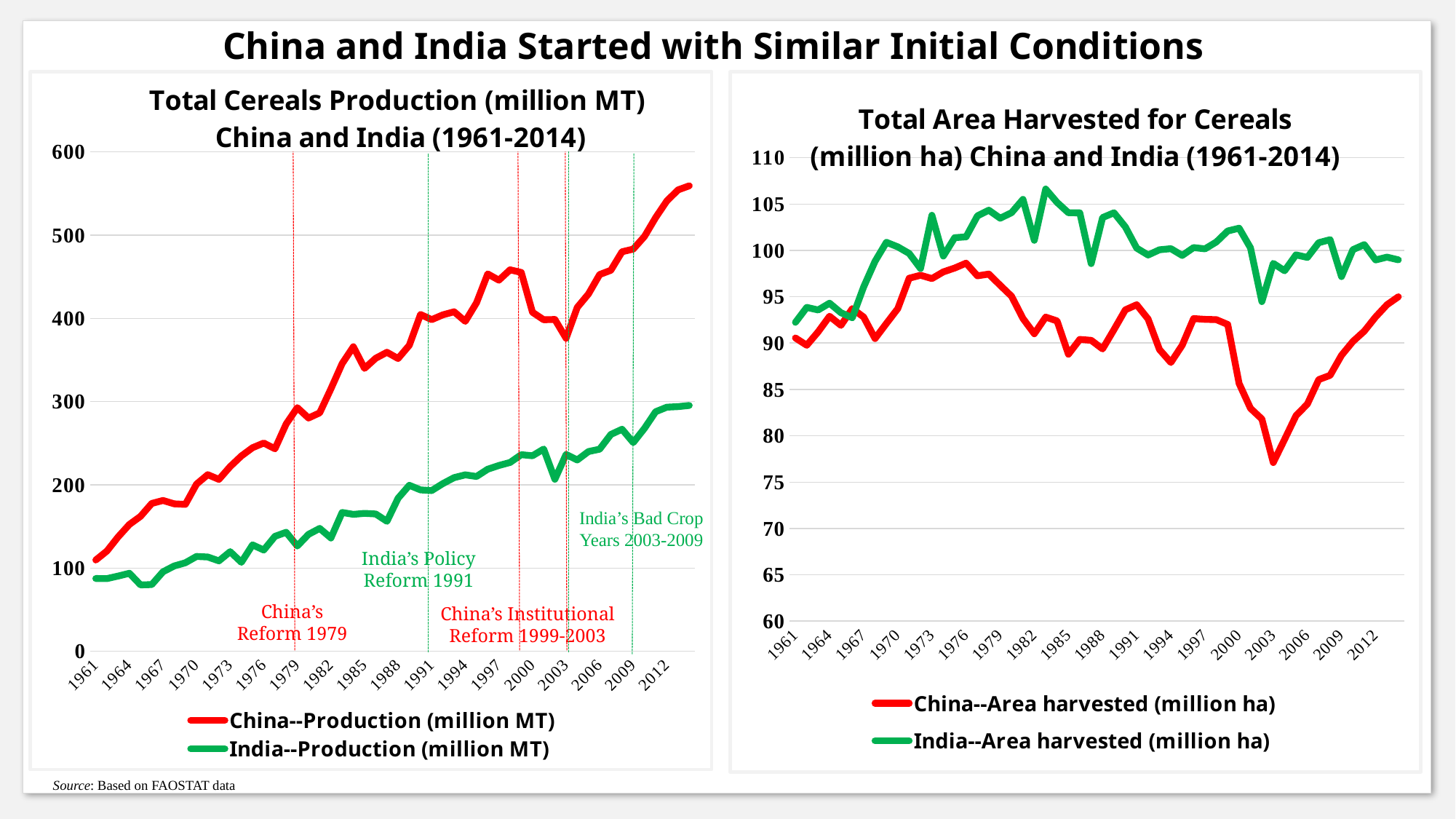
What kind of chart is the 'Total Cereals Production (million MT)' chart on the left? line chart In the 'Total Cereals Production' chart on the left, which country has the higher production in 2012, China or India? China How many series does the legend of the 'Total Area Harvested for Cereals' chart on the right list? 2 In the 'Total Area Harvested for Cereals' chart on the right, is the value for China in 2003 greater or less than 80? less In the 'Total Cereals Production' chart on the left, what year is labelled as China's Reform? 1979 In the 'Total Cereals Production' chart on the left, does India's production generally rise or fall from 1961 to 2014? rise In the 'Total Cereals Production' chart on the left, is the value for India in 1961 greater or less than 100? less In the 'Total Cereals Production' chart on the left, is the value for China in 2012 greater or less than 500? greater In the 'Total Area Harvested for Cereals' chart on the right, what colour is the line for India? green In the 'Total Area Harvested for Cereals' chart on the right, which country has the larger area harvested in 2003, China or India? India